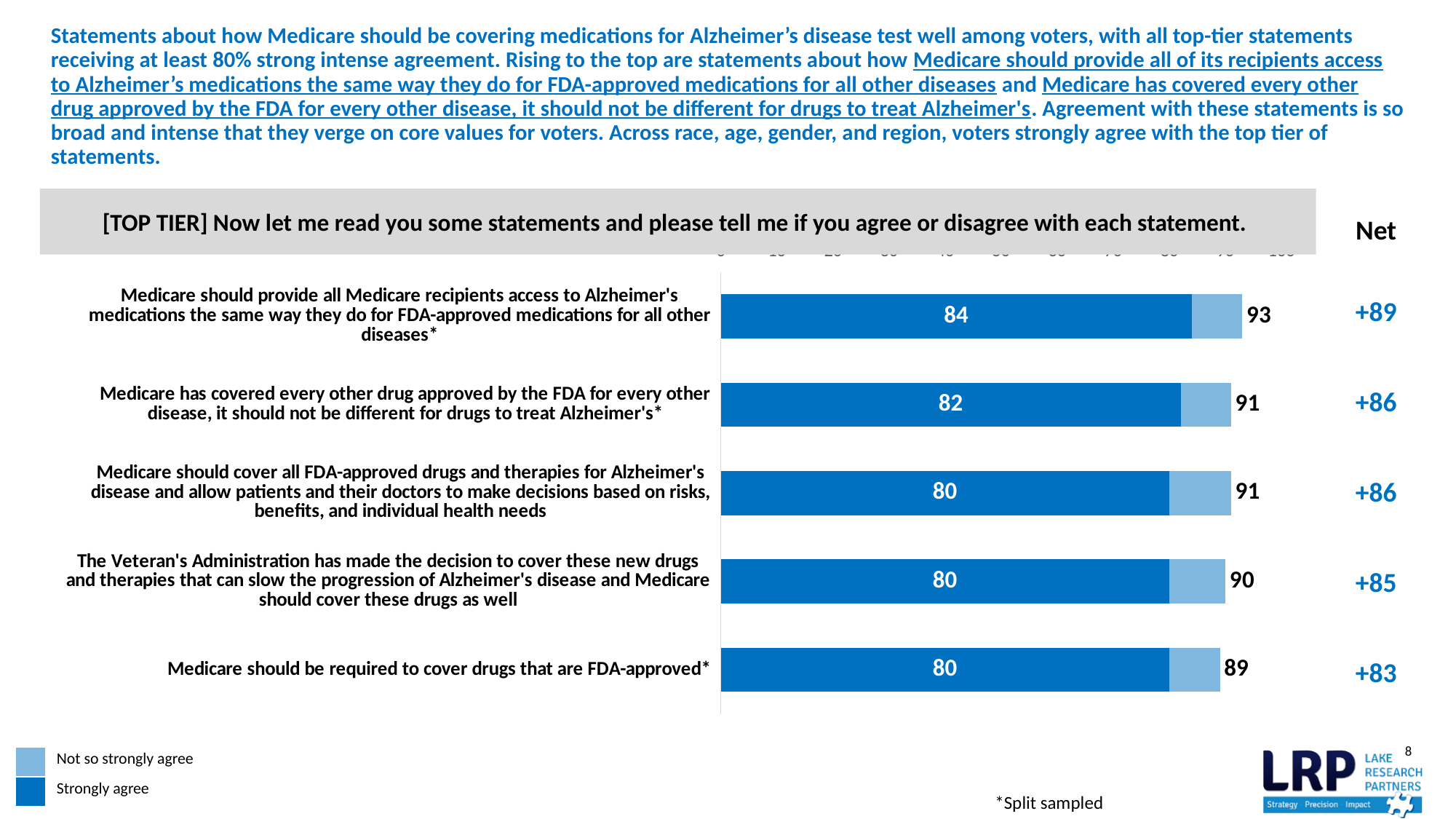
What is the difference between the total agreement and the strongly agree share for the statement about the Veteran's Administration covering these new drugs? 10 How many series does the legend list? 2 Which has a higher Net value: the statement about the Veteran's Administration or the statement that Medicare should be required to cover FDA-approved drugs? The Veteran's Administration statement How many statements are shown in the chart? 5 How many more points of strong agreement does the top statement (84) have than the statement about Medicare covering every other FDA-approved drug (82)? 2 What is the Net value shown for the statement that Medicare has covered every other drug approved by the FDA for every other disease, it should not be different for drugs to treat Alzheimer's? +86 What kind of chart is shown on the slide? Stacked bar chart Which statement has the lowest total agreement? Medicare should be required to cover drugs that are FDA-approved Which statement has the highest share of voters who strongly agree? Medicare should provide all Medicare recipients access to Alzheimer's medications the same way they do for FDA-approved medications for all other diseases What percentage of voters strongly agree that Medicare should provide all Medicare recipients access to Alzheimer's medications the same way they do for FDA-approved medications for all other diseases? 84 Which legend entry is shown in the darker blue colour? Strongly agree What is the total agreement (strongly plus not so strongly) for the statement that Medicare should be required to cover drugs that are FDA-approved? 89